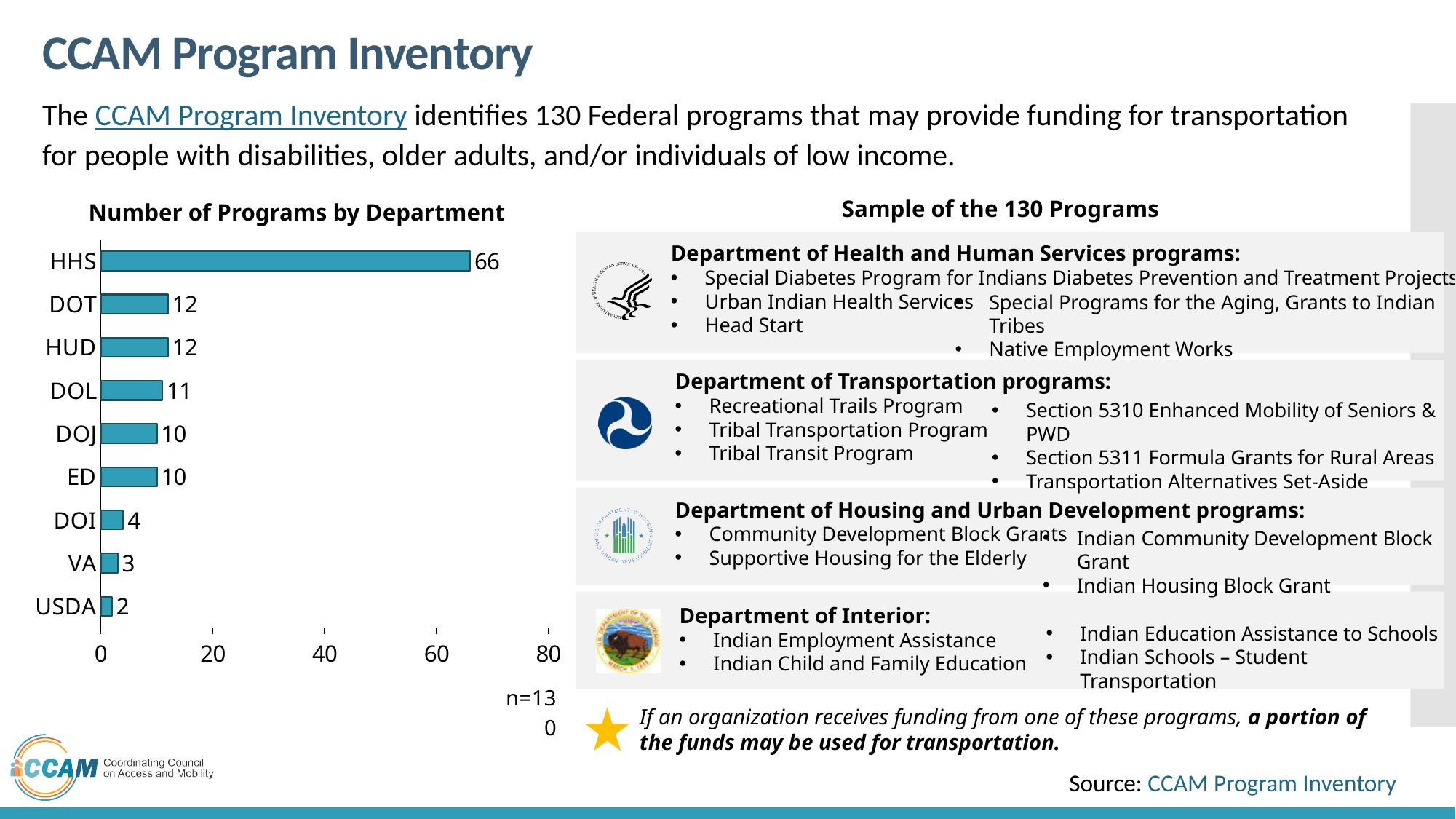
What is the number of programs for HHS? 66 What is the number of programs for VA? 3 Is the value for HHS greater or less than 60? greater What is the number of programs for DOL? 11 Which has more programs, DOJ or DOI? DOJ What kind of chart is used to show the number of programs by department? Bar chart What is the difference between the number of programs for DOL and DOI? 7 Which department has the lowest number of programs? USDA What is the title of the chart? Number of Programs by Department Which department has the highest number of programs? HHS How many departments are shown in the chart? 9 What is the difference between the number of programs for HHS and DOT? 54